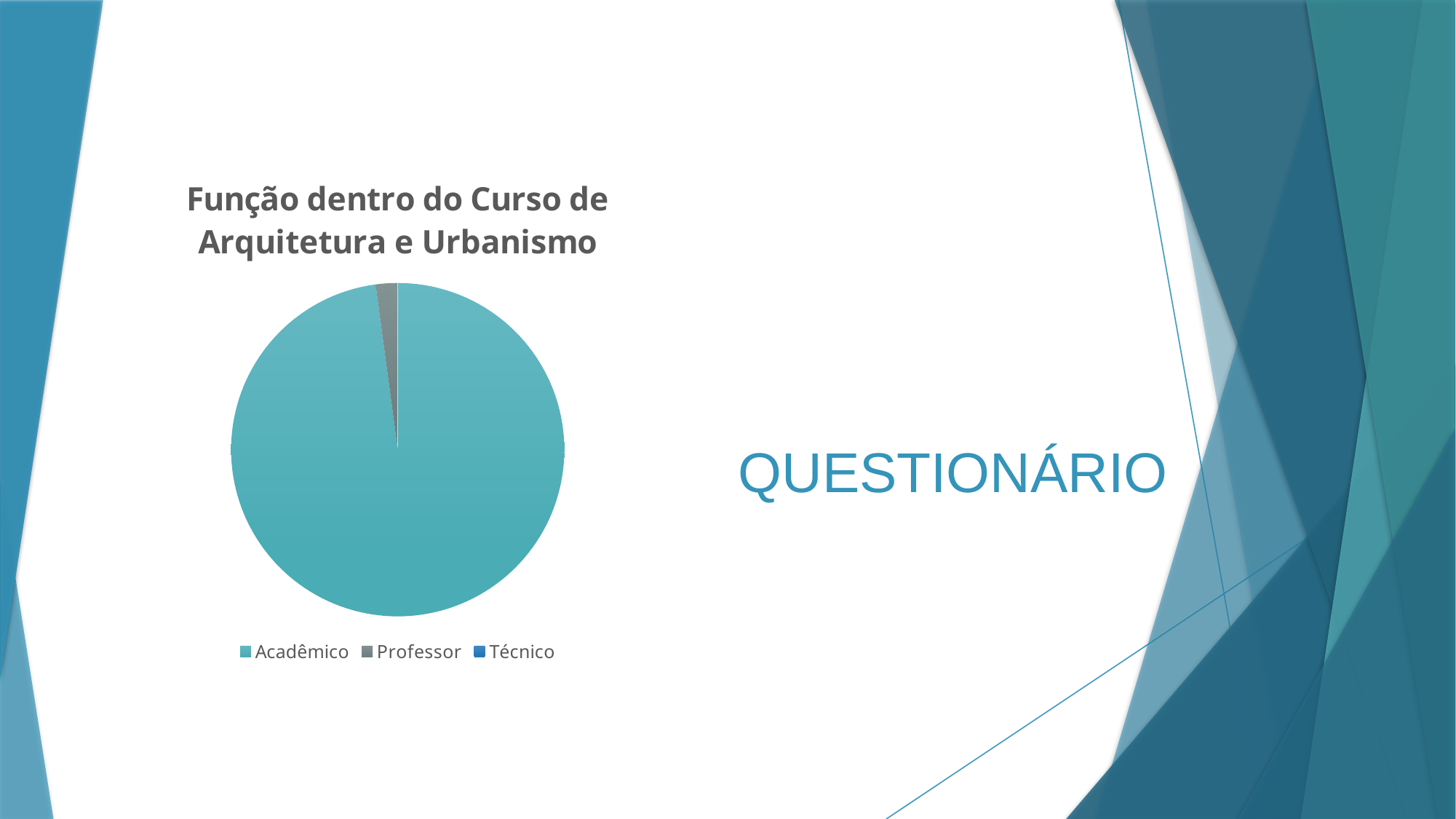
Which is larger in the pie chart, Acadêmico or Professor? Acadêmico What is the title of the chart? Função dentro do Curso de Arquitetura e Urbanismo Which category has the largest slice of the pie chart? Acadêmico Does the Acadêmico slice take up more or less than half of the pie chart? more What kind of chart is shown on the slide? pie chart Which legend entry is shown in grey in the pie chart? Professor How many categories does the legend of the pie chart list? 3